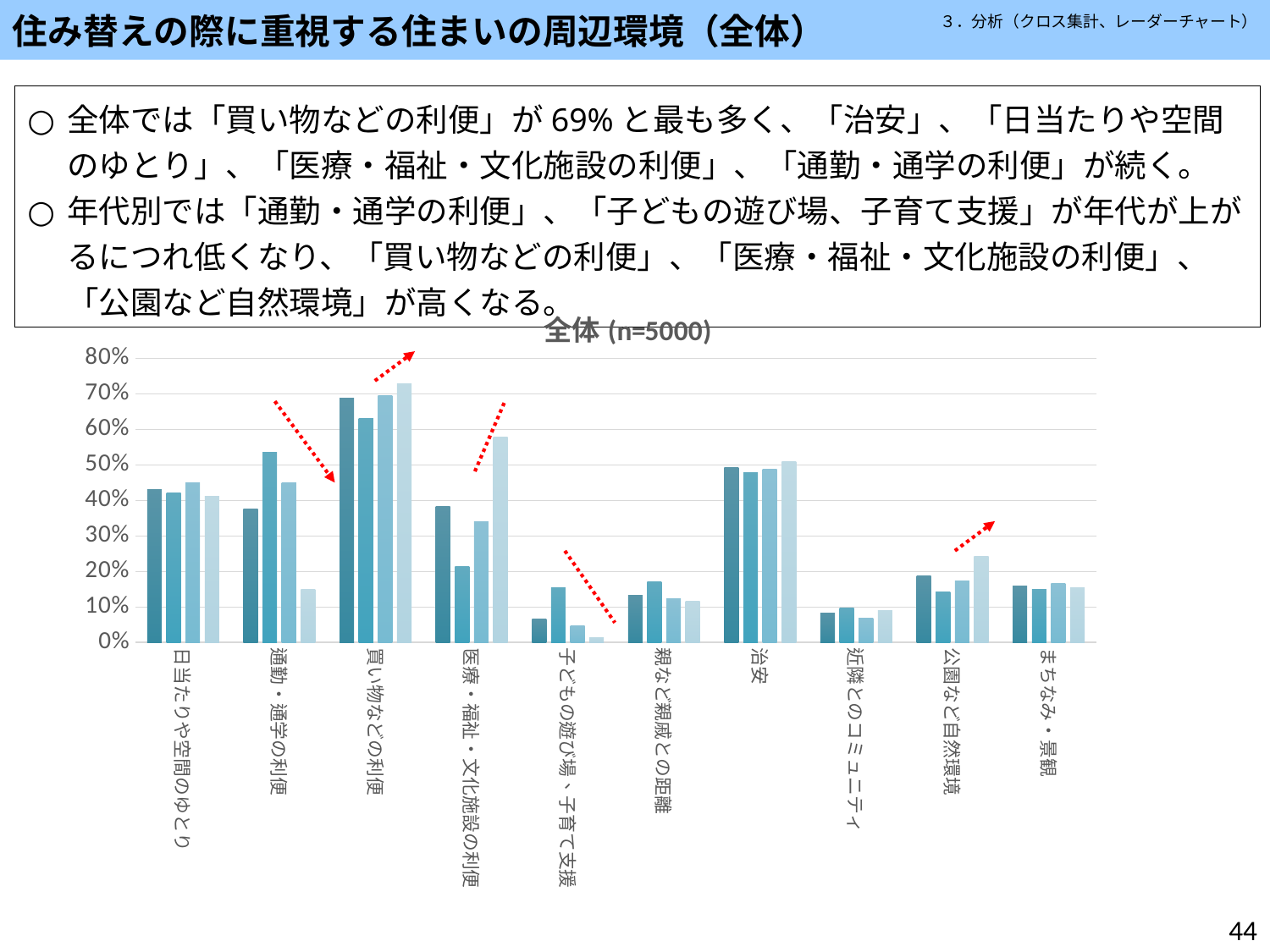
Which category has the taller fourth (lightest) bar, 公園など自然環境 or まちなみ・景観? 公園など自然環境 Is the tallest bar for 買い物などの利便 greater or less than 70%? greater Which category has taller bars overall, 治安 or 親など親戚との距離? 治安 Which category has the tallest bar in the chart? 買い物などの利便 How many bars are plotted for each category in the chart? 4 Which category has the shortest bar in the chart? 子どもの遊び場、子育て支援 What is the highest value shown on the chart's vertical axis? 80% How many categories are shown along the x axis of the chart? 10 Is the first bar for 治安 greater or less than 40%? greater What kind of chart is shown on the slide? bar chart What is the title of the chart? 全体 (n=5000) Are all the bars for 近隣とのコミュニティ greater or less than 20%? less